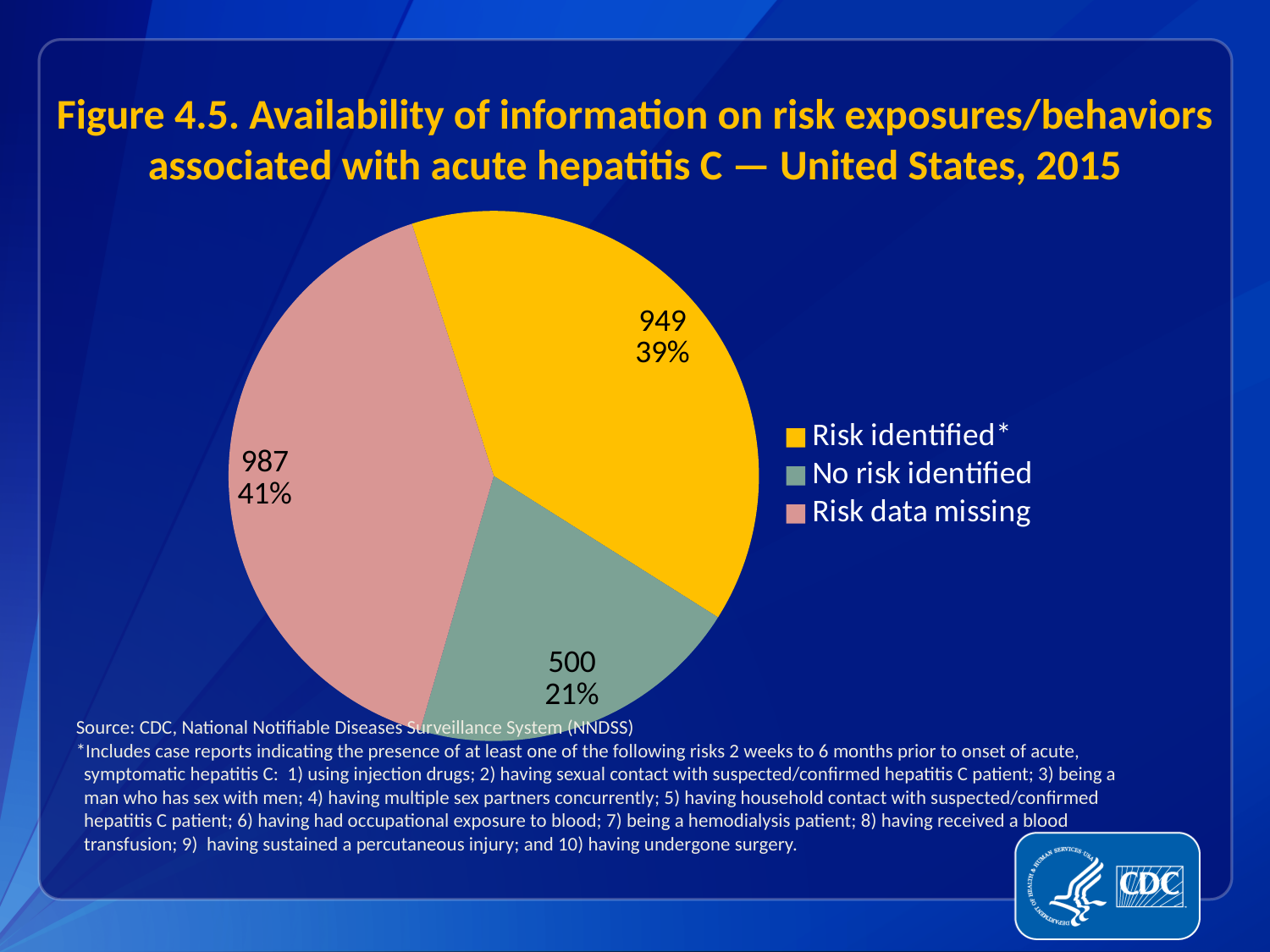
What colour is the 'Risk identified*' slice? yellow What is the difference in cases between 'Risk data missing' and 'Risk identified*'? 38 What percentage of the pie is 'No risk identified'? 21% What is the total number of cases across all three slices? 2436 Which category has the smallest slice? No risk identified What type of chart is shown on the slide? pie chart Which category has the largest slice? Risk data missing What percentage of the pie is 'Risk data missing'? 41% Which is larger, 'Risk identified*' or 'No risk identified'? Risk identified* How many cases are in the 'Risk data missing' slice? 987 How many slices does the pie chart have? 3 How many cases are in the 'Risk identified*' slice? 949